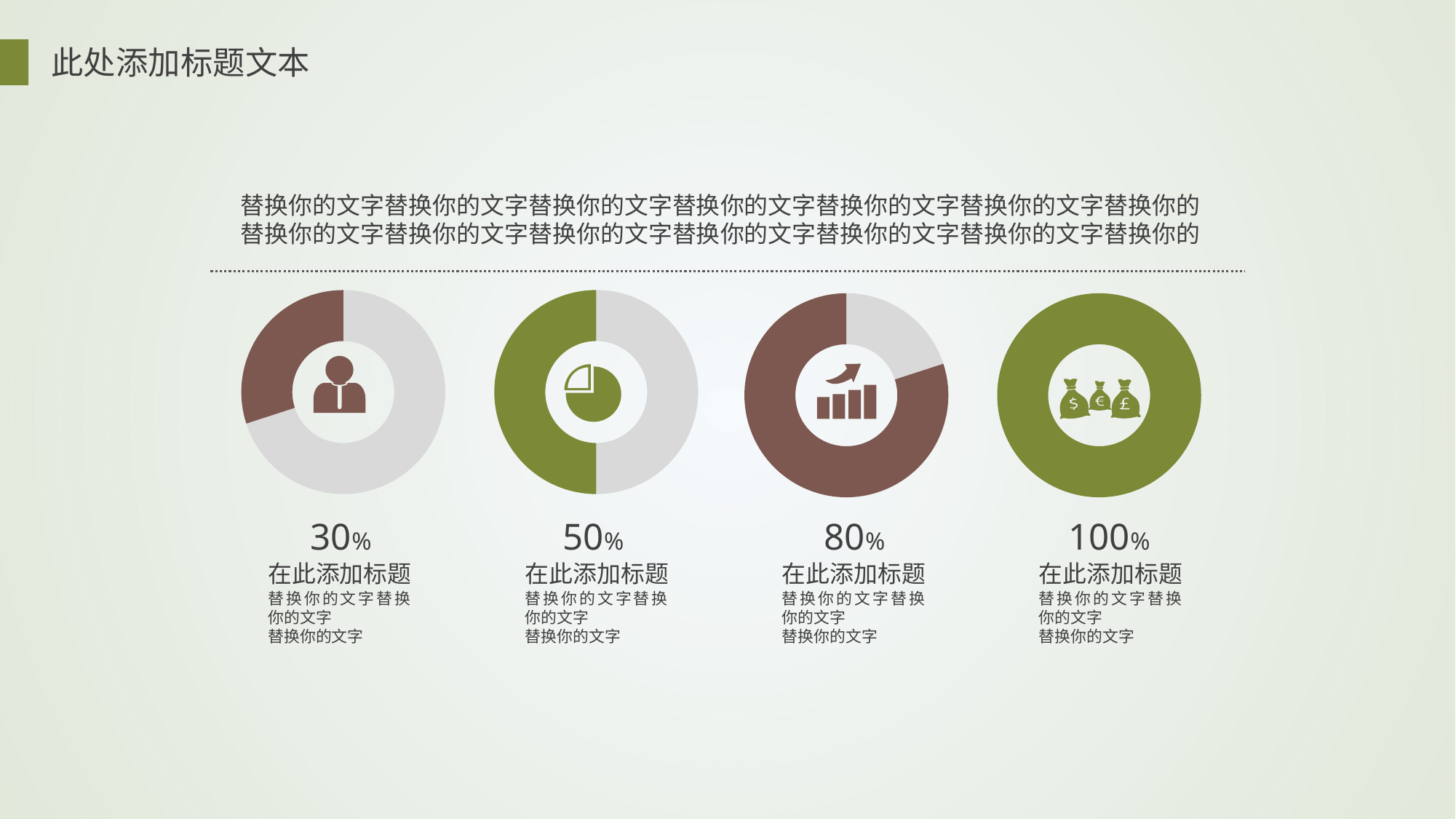
What percentage is shown below the second donut chart from the left? 50% Do the percentages rise or fall from the leftmost donut chart to the rightmost? Rise Which donut chart shows the highest percentage? The rightmost one (100%) What is the difference between the percentage of the third donut chart and the second donut chart? 30% How many donut charts are on the slide? 4 What is the difference between the percentage of the rightmost donut chart and the leftmost donut chart? 70% What percentage is shown below the third donut chart from the left? 80% Which is larger, the percentage of the second donut chart or the third donut chart? The third donut chart (80%) What kind of charts are shown on the slide? Donut charts What percentage is shown below the rightmost donut chart? 100% What percentage is shown below the leftmost donut chart? 30% Which donut chart shows the lowest percentage? The leftmost one (30%)